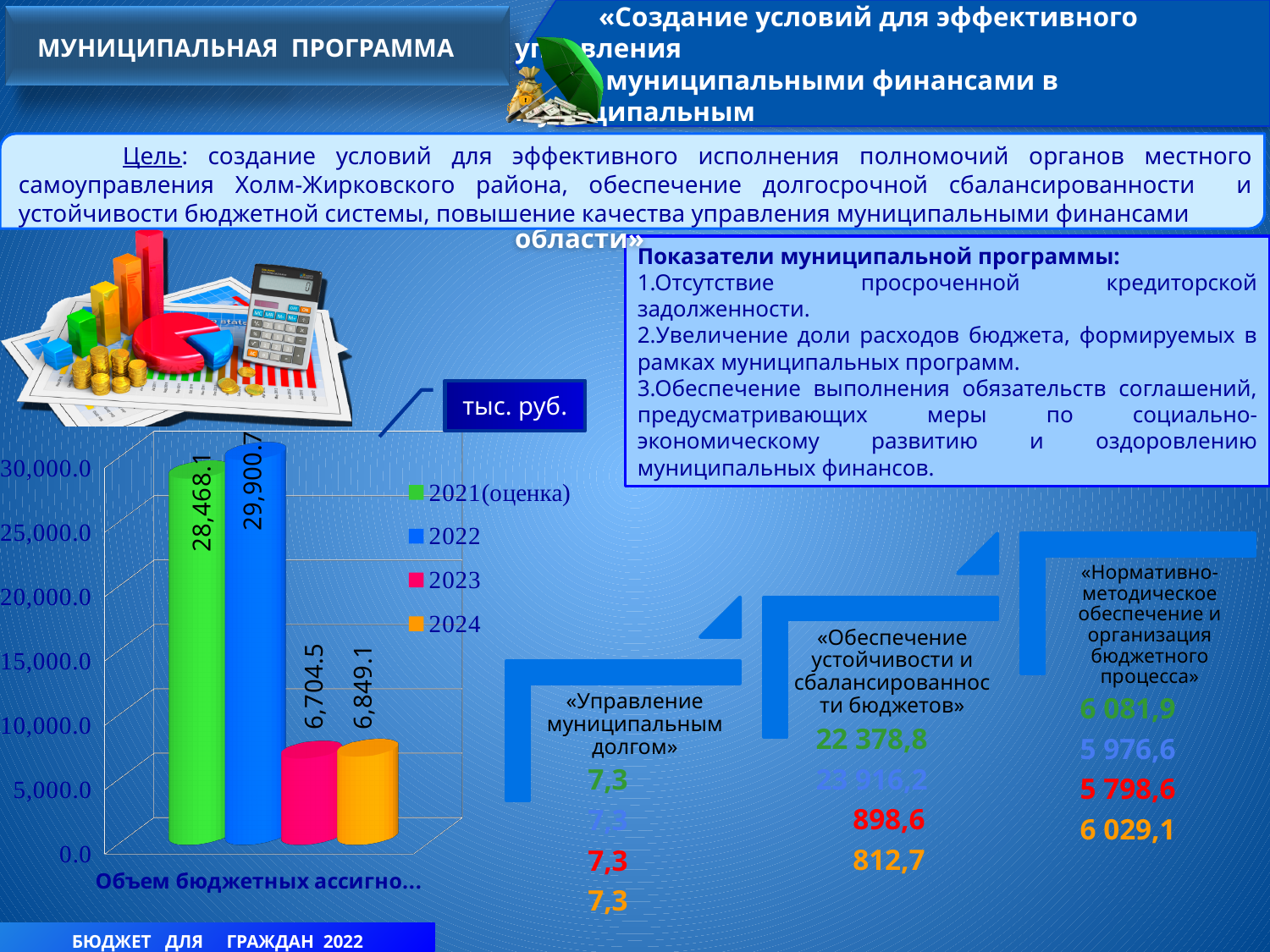
Which is larger in the bar chart: the value for 2021(оценка) or the value for 2024? 2021(оценка) Which series has the highest value in the bar chart? 2022 What is the value for 2021(оценка) in the bar chart? 28,468.1 What is the difference between the 2024 value and the 2023 value in the bar chart? 144.6 What is the value for 2024 in the bar chart? 6,849.1 What is the difference between the 2022 value and the 2021(оценка) value in the bar chart? 1,432.6 What kind of chart is shown on the slide? bar chart What is the value for 2022 in the bar chart? 29,900.7 How many series does the legend of the bar chart list? 4 What unit is indicated for the values in the bar chart? тыс. руб. What is the value for 2023 in the bar chart? 6,704.5 Which series has the lowest value in the bar chart? 2023